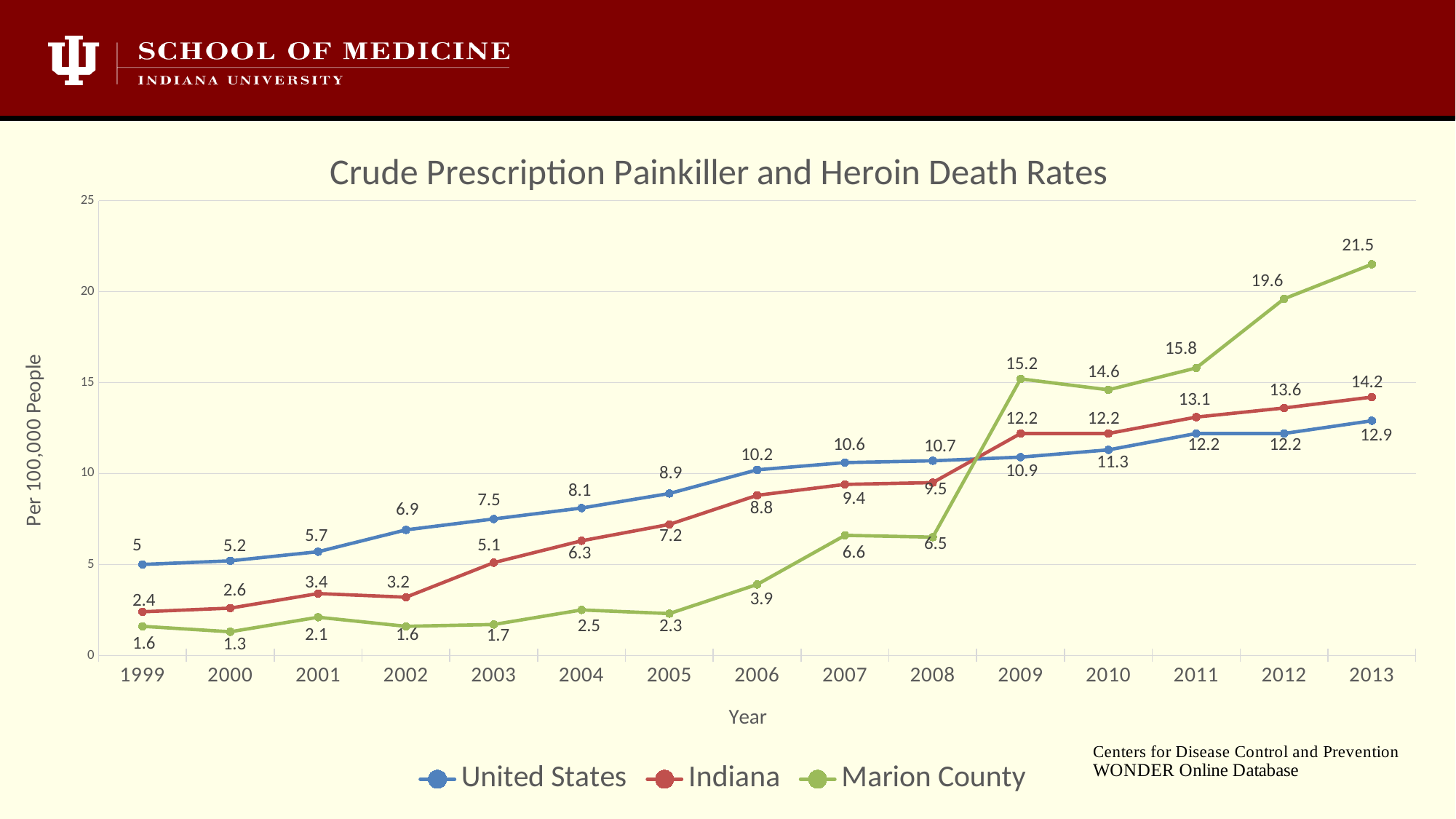
In which year is the Marion County death rate lowest? 2000 Which series has the highest value in 2013? Marion County What is the Marion County death rate in 2013? 21.5 How many years are plotted on the x axis? 15 Which is larger in 2008, the United States rate or the Marion County rate? United States Does the United States death rate generally rise or fall from 1999 to 2013? Rise What type of chart is shown on the slide? Line chart What is the label of the y axis? Per 100,000 People What is the difference between the Indiana and United States death rates in 2013? 1.3 What is the Indiana death rate in 2003? 5.1 How many series does the legend list? 3 What is the United States death rate in 2006? 10.2